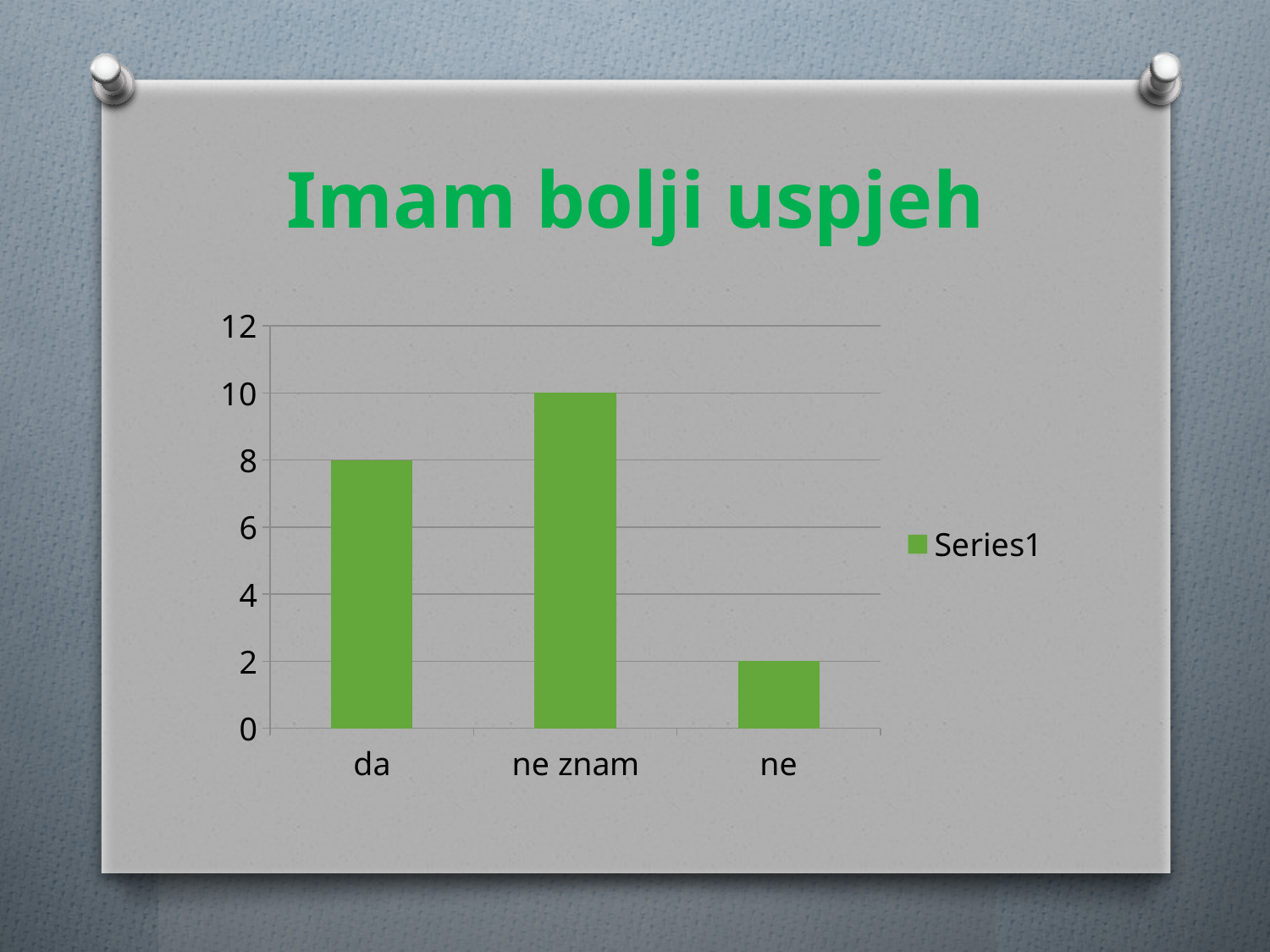
Is the value for "ne znam" greater or less than 6? greater Which category has the highest value? ne znam What is the value for "da"? 8 What kind of chart is shown on the slide? bar chart Which category has the lowest value? ne What is the difference between the values for "da" and "ne"? 6 Which is larger, the value for "da" or the value for "ne"? da What is the difference between the values for "ne znam" and "da"? 2 How many categories are shown on the x axis? 3 How many series does the legend list? 1 What is the value for "ne znam"? 10 What is the value for "ne"? 2